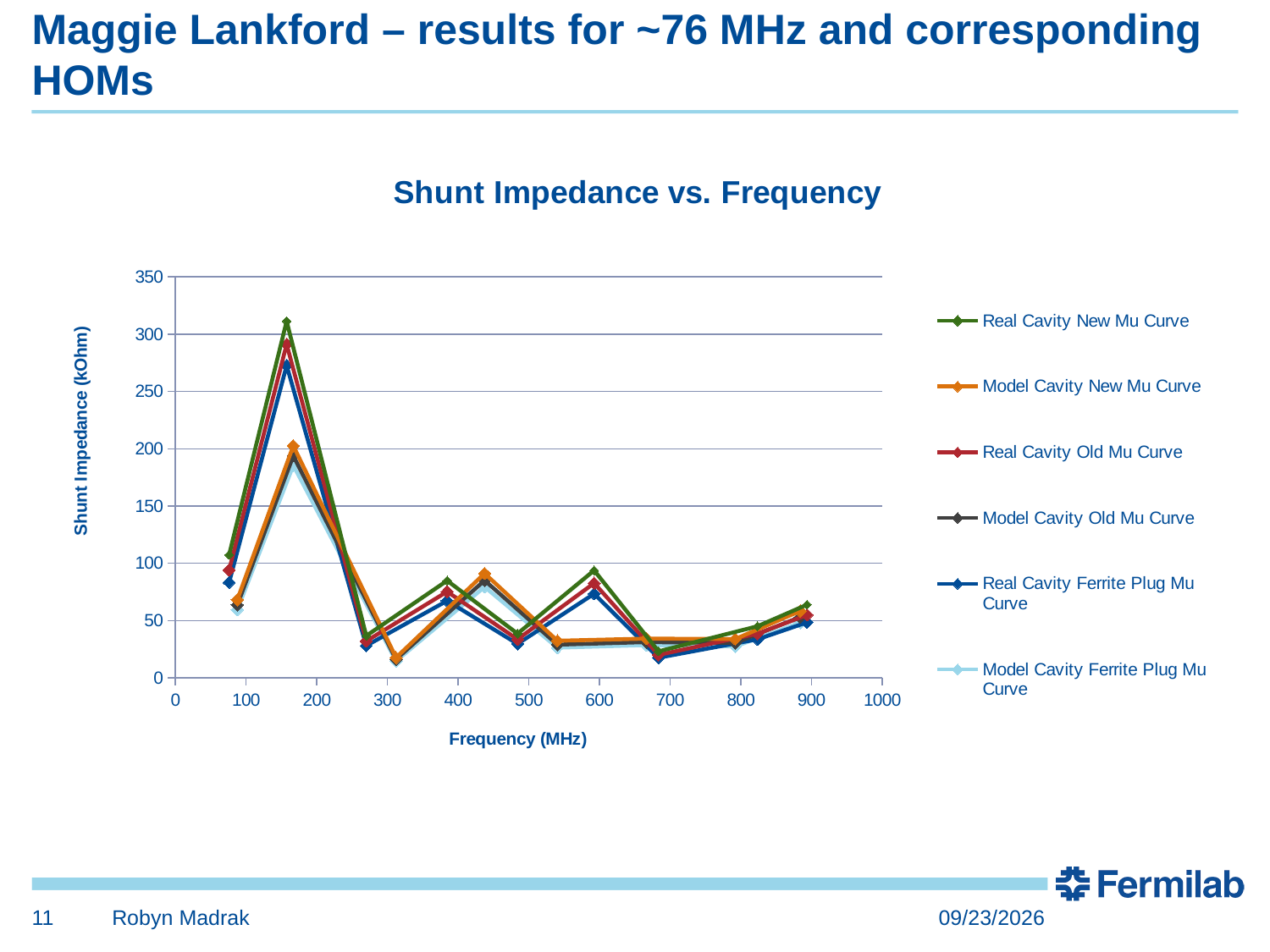
Is the peak value of the Real Cavity New Mu Curve greater or less than 300? greater Is the peak value of the Model Cavity New Mu Curve greater or less than 250? less Is the value of the Real Cavity New Mu Curve at about 900 MHz greater or less than 100? less What is the label of the vertical axis of the chart? Shunt Impedance (kOhm) How many series does the legend of the chart list? 6 Between about 200 MHz and 300 MHz, do the shunt impedance values rise or fall along the x axis? Fall What kind of chart is shown on the slide? Line chart What is the title of the chart? Shunt Impedance vs. Frequency At its peak near 160 MHz, which is larger: the Real Cavity New Mu Curve or the Model Cavity New Mu Curve? Real Cavity New Mu Curve Which series reaches the highest shunt impedance value on the chart? Real Cavity New Mu Curve